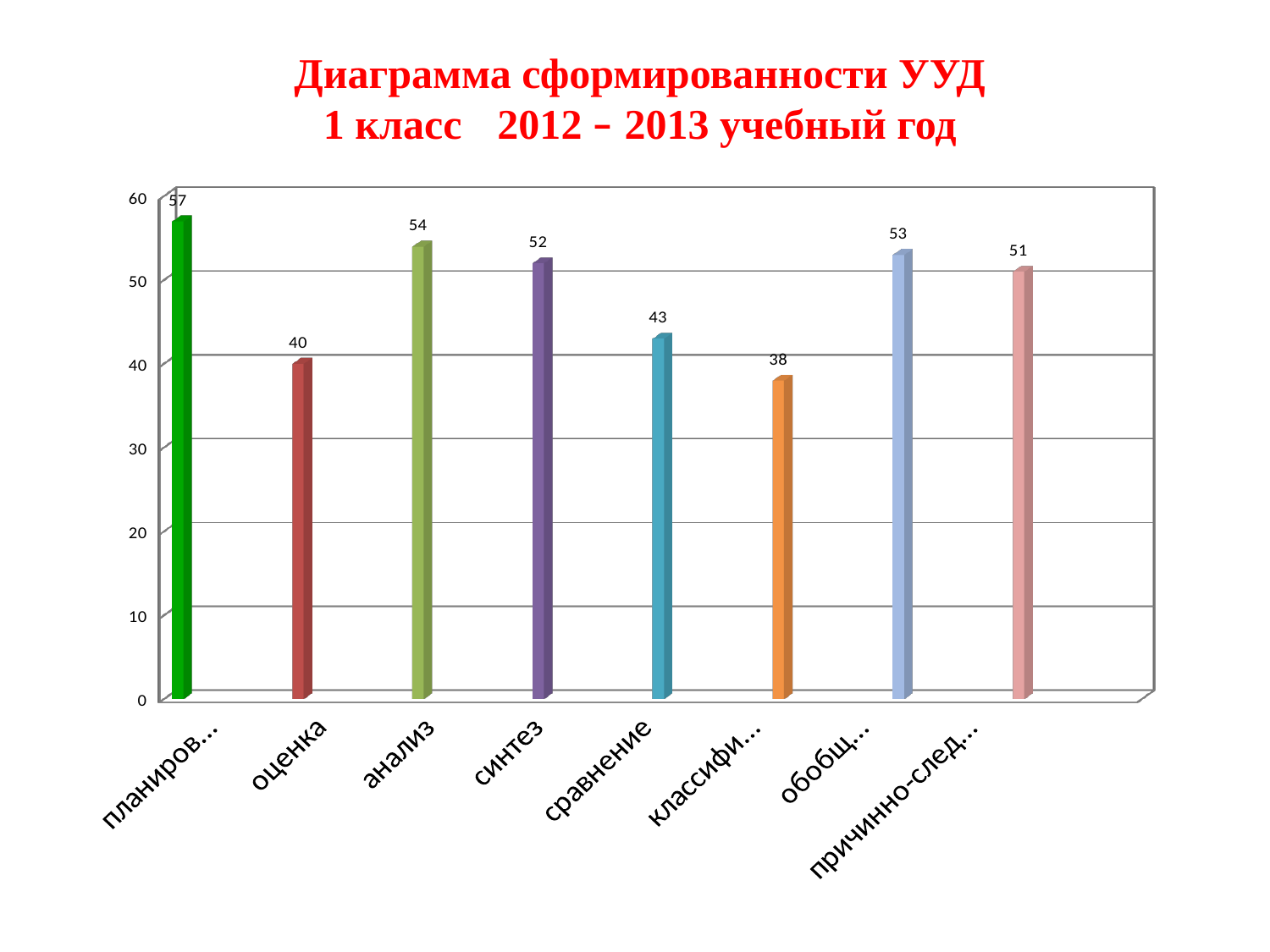
What is the highest value shown in the chart? 57 What is the value for оценка? 40 Is the value for сравнение greater or less than 50? less Which is larger, the value for синтез or the value for сравнение? синтез What is the value for синтез? 52 What is the value for анализ? 54 What is the difference between the values for анализ and оценка? 14 How many bars (categories) are plotted in the chart? 8 What is the lowest value shown in the chart? 38 What is the value for сравнение? 43 What type of chart is shown on the slide? bar chart What is the title of the slide above the chart? Диаграмма сформированности УУД 1 класс 2012 – 2013 учебный год